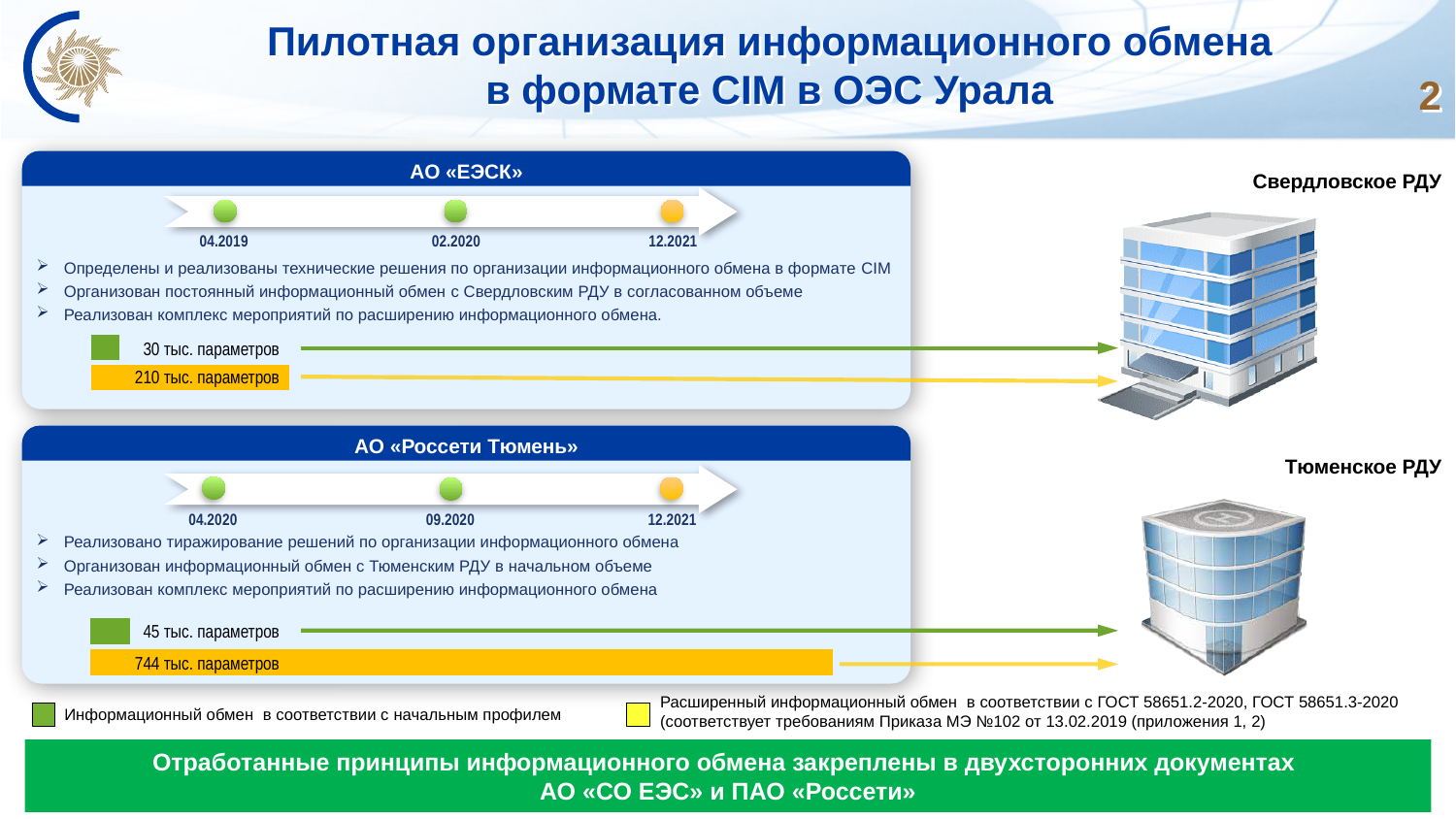
Across both panels, which bar shows the smallest number of parameters? 30 тыс. параметров (АО «ЕЭСК», initial profile) In the АО «Россети Тюмень» panel, what value is shown for the green bar (initial profile exchange)? 45 тыс. параметров How many series does the legend at the bottom of the slide list? 2 Which is larger: the extended exchange value for АО «ЕЭСК» or for АО «Россети Тюмень»? АО «Россети Тюмень» In the АО «ЕЭСК» panel, what value is shown for the green bar (initial profile exchange)? 30 тыс. параметров In the АО «Россети Тюмень» panel, what value is shown for the yellow bar (extended exchange)? 744 тыс. параметров What type of chart is used to show the number of parameters in each panel? Bar chart In the АО «ЕЭСК» panel, what value is shown for the yellow bar (extended exchange)? 210 тыс. параметров Across both panels, which bar shows the largest number of parameters? 744 тыс. параметров (АО «Россети Тюмень», extended exchange) Which colour represents the extended information exchange (расширенный информационный обмен) in the legend? Yellow In the АО «ЕЭСК» panel, what is the difference between the extended exchange and the initial profile values? 180 тыс. параметров In the АО «Россети Тюмень» panel, what is the difference between the extended exchange and the initial profile values? 699 тыс. параметров